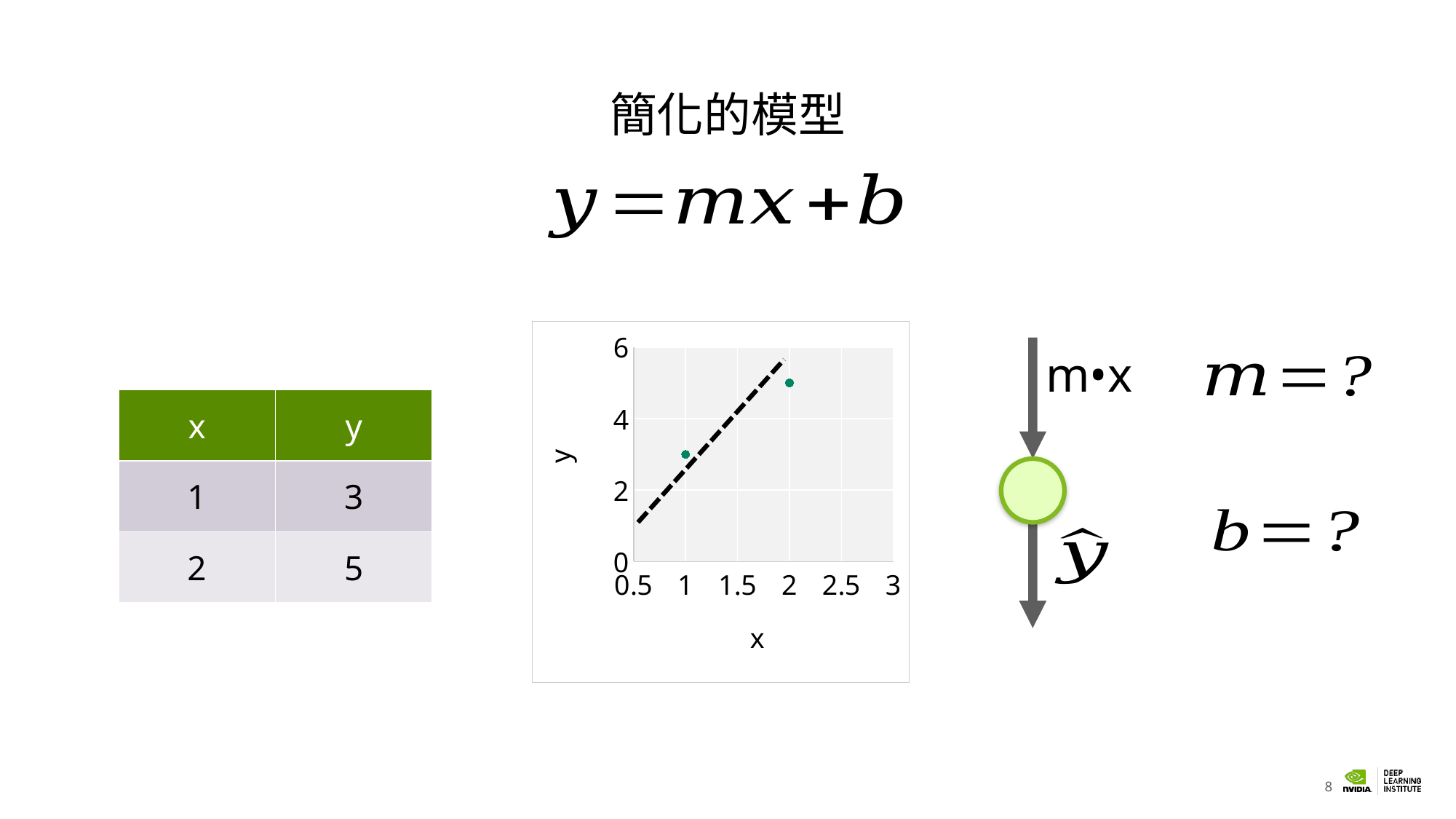
According to the slide, what is the y value when x = 1? 3 What is the difference between the y values at x = 2 and x = 1? 2 Is the y value of the point at x = 1 greater or less than 4? less According to the slide, what is the y value when x = 2? 5 Do the plotted y values rise or fall as x increases? rise Is the y value of the point at x = 2 greater or less than 4? greater Which point has the larger y value, the one at x = 1 or the one at x = 2? x = 2 How many data points are plotted in the chart? 2 At which x value does the plotted point have the highest y value? 2 What is the label on the horizontal axis of the chart? x What is the highest tick value shown on the vertical axis of the chart? 6 What kind of chart is shown on the slide? scatter chart